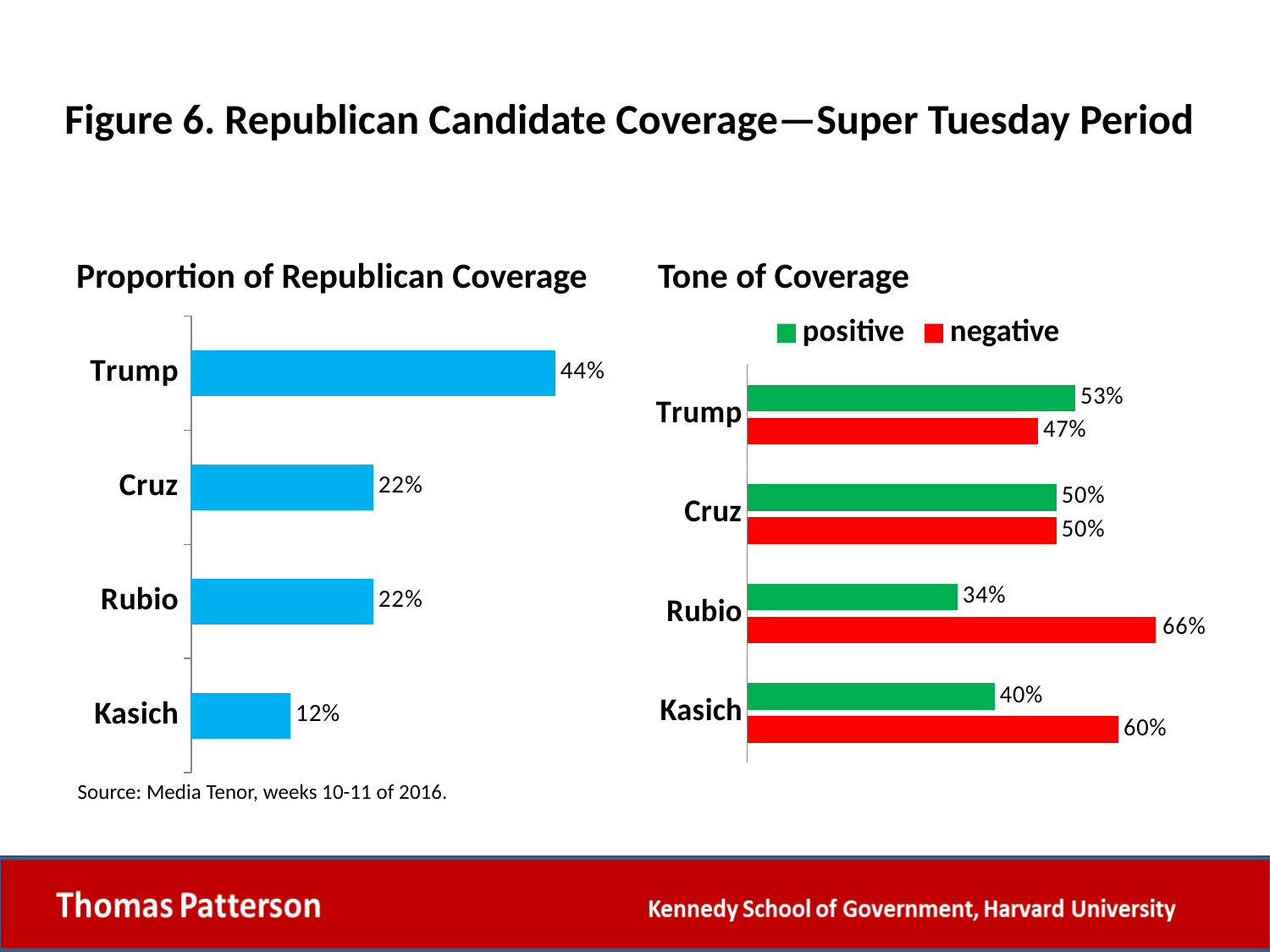
In the 'Tone of Coverage' chart, how many series does the legend list? 2 In the 'Tone of Coverage' chart, what is the positive value for Kasich? 40% In the 'Proportion of Republican Coverage' chart, how many candidates are shown? 4 In the 'Tone of Coverage' chart, is Trump's positive value or negative value larger? positive In the 'Tone of Coverage' chart, which candidate has the highest positive value? Trump In the 'Proportion of Republican Coverage' chart, which candidate has the lowest proportion of coverage? Kasich In the 'Proportion of Republican Coverage' chart, what is the value for Trump? 44% In the 'Tone of Coverage' chart, which candidate has the lowest positive value? Rubio What kind of chart is the 'Proportion of Republican Coverage' chart? bar chart In the 'Tone of Coverage' chart, what is the negative value for Rubio? 66% In the 'Proportion of Republican Coverage' chart, what is the difference between Trump's and Cruz's values? 22% In the 'Tone of Coverage' chart, what is the difference between Kasich's negative and positive values? 20%